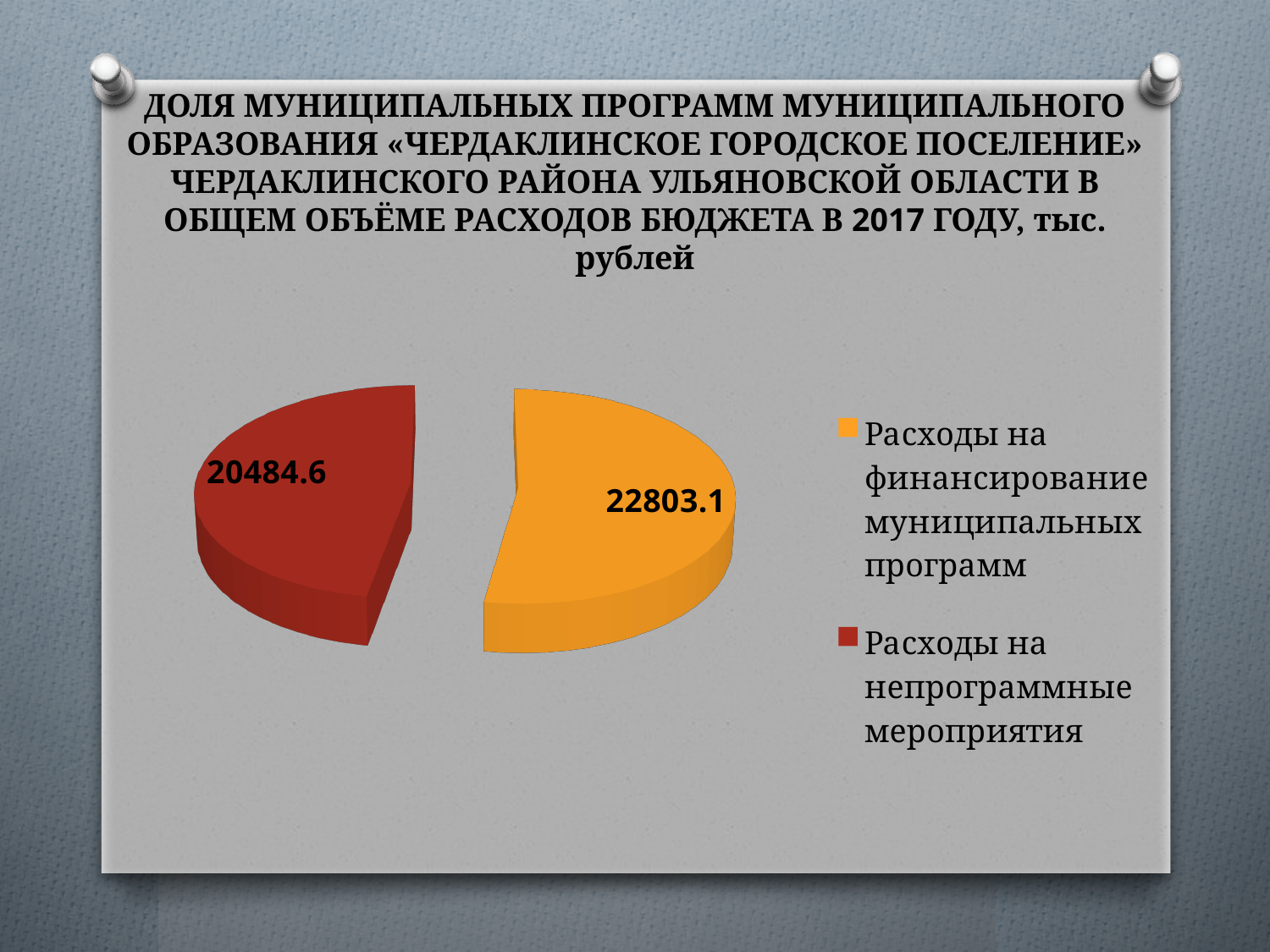
What is the value for «Расходы на финансирование муниципальных программ»? 22803.1 What is the value for «Расходы на непрограммные мероприятия»? 20484.6 Which category has the smallest slice of the pie? Расходы на непрограммные мероприятия Which is larger: «Расходы на финансирование муниципальных программ» or «Расходы на непрограммные мероприятия»? Расходы на финансирование муниципальных программ What is the total of the two values shown in the pie chart? 43287.7 What share of the pie does «Расходы на финансирование муниципальных программ» represent, to one decimal place? 52.7% What is the difference between the value for «Расходы на финансирование муниципальных программ» and the value for «Расходы на непрограммные мероприятия»? 2318.5 Which category has the largest slice of the pie? Расходы на финансирование муниципальных программ How many entries does the legend list? 2 What type of chart is shown on the slide? Pie chart What colour is the slice for «Расходы на непрограммные мероприятия»? Red How many slices does the pie chart have? 2